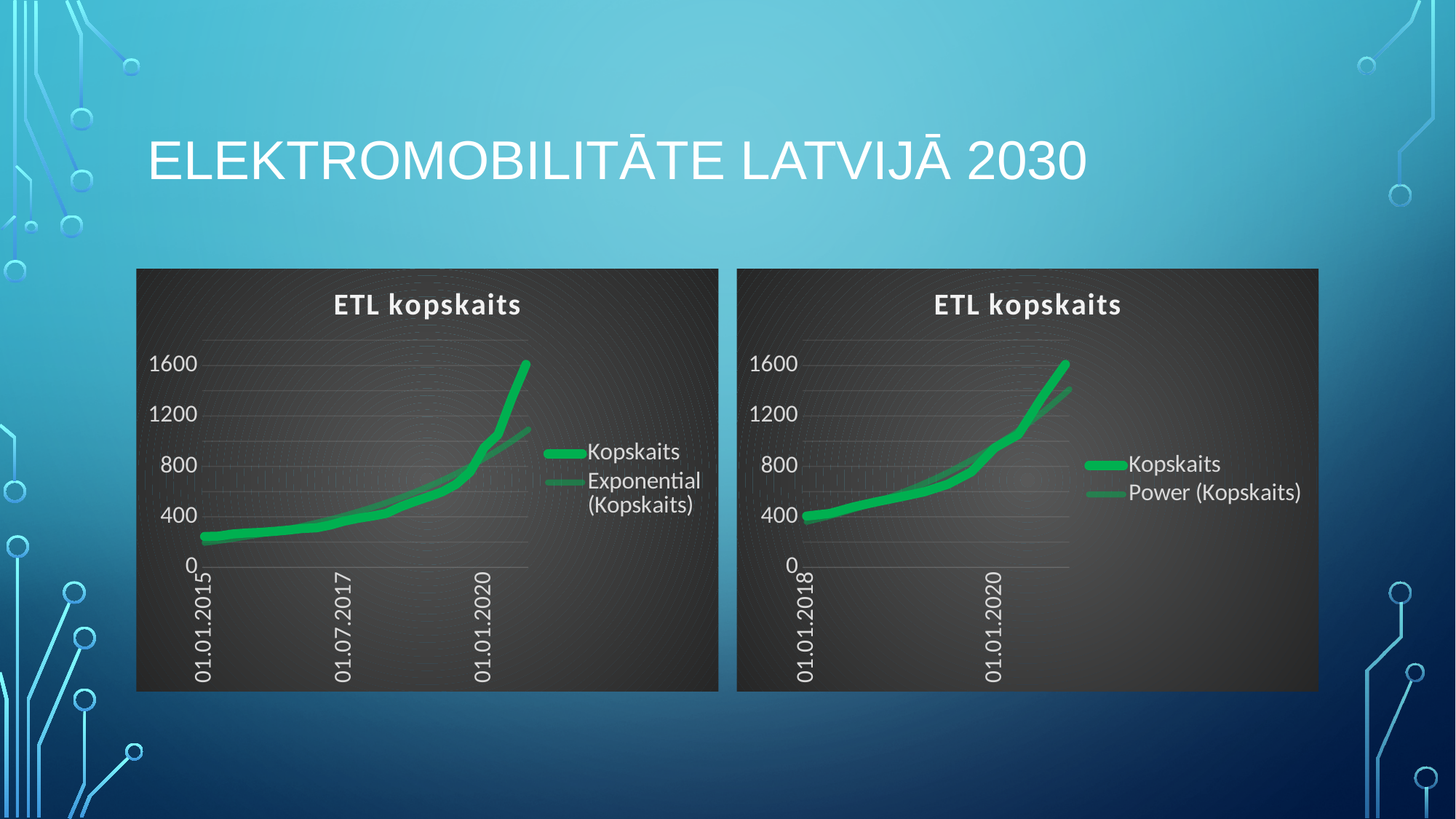
In the right chart, how many series does the legend list? 2 In the left chart, is the final Kopskaits value greater or less than 1200? greater In the right chart, is the final Kopskaits value greater or less than 1200? greater In the left chart, is the Kopskaits value at 01.01.2015 greater or less than 400? less In the left chart, does the Kopskaits line rise or fall from 01.01.2015 to the end of the series? rise What type of chart is the right chart titled "ETL kopskaits"? line chart In the left chart, how many series does the legend list? 2 In the right chart, does the Kopskaits line rise or fall from 01.01.2018 onward? rise In the right chart, what is the name of the trendline series in the legend? Power (Kopskaits) In the left chart, at the last point of the series, which line is higher: Kopskaits or Exponential (Kopskaits)? Kopskaits In the left chart, what are the two legend entries? Kopskaits and Exponential (Kopskaits) What type of chart is the left chart titled "ETL kopskaits"? line chart